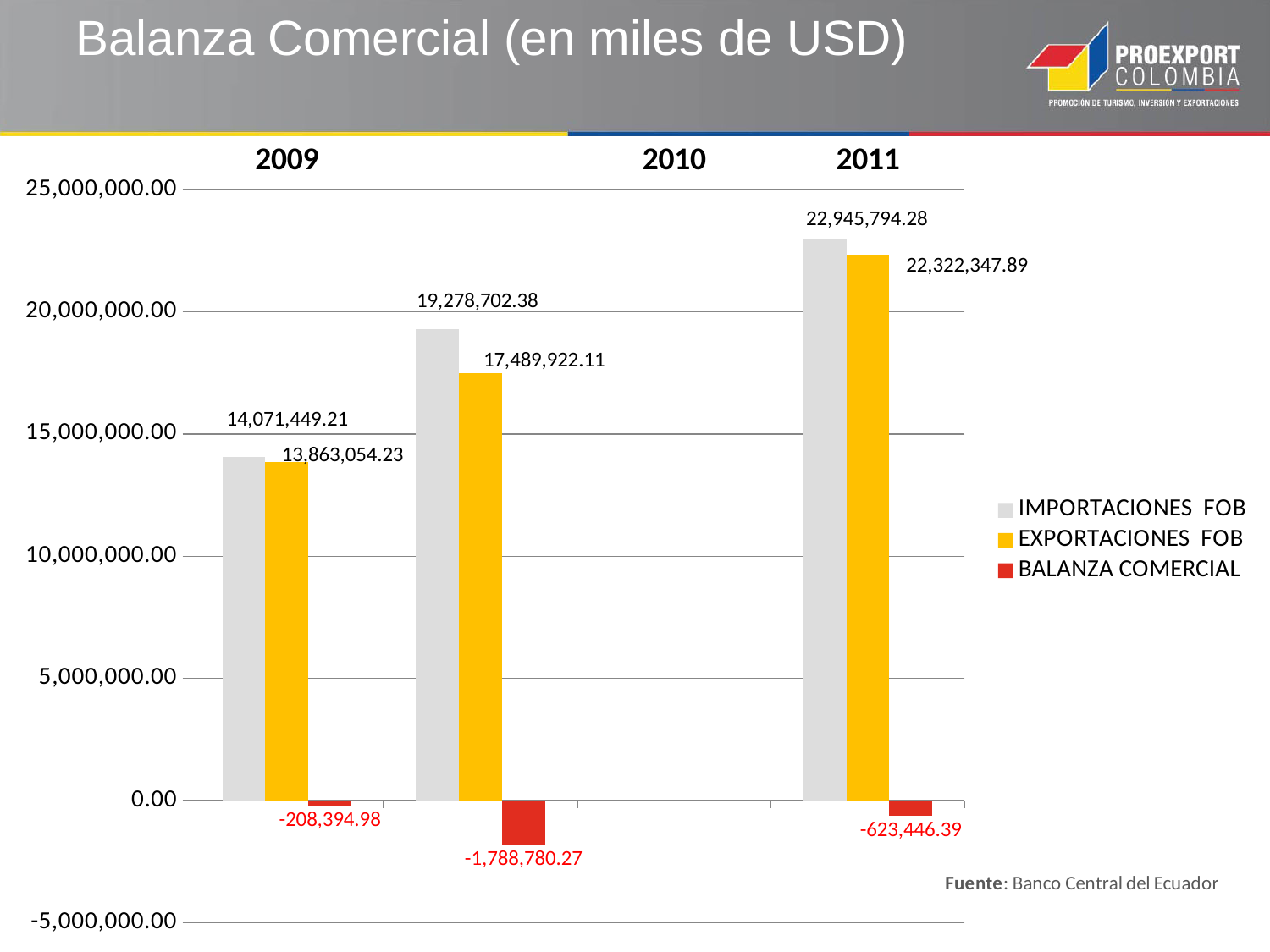
What kind of chart is shown on the slide? bar chart What is the difference between IMPORTACIONES FOB and EXPORTACIONES FOB in 2011? 623,446.39 What is the value of EXPORTACIONES FOB for 2010? 17,489,922.11 What is the value of IMPORTACIONES FOB for 2009? 14,071,449.21 Which is larger in 2009, IMPORTACIONES FOB or EXPORTACIONES FOB? IMPORTACIONES FOB In which year is IMPORTACIONES FOB highest? 2011 Do the EXPORTACIONES FOB values rise or fall from 2009 to 2011? rise What is the value of BALANZA COMERCIAL for 2011? -623,446.39 How many series does the legend list? 3 In which year is BALANZA COMERCIAL lowest? 2010 How many years are shown on the x axis of the chart? 3 What is the title of the chart on the slide? Balanza Comercial (en miles de USD)